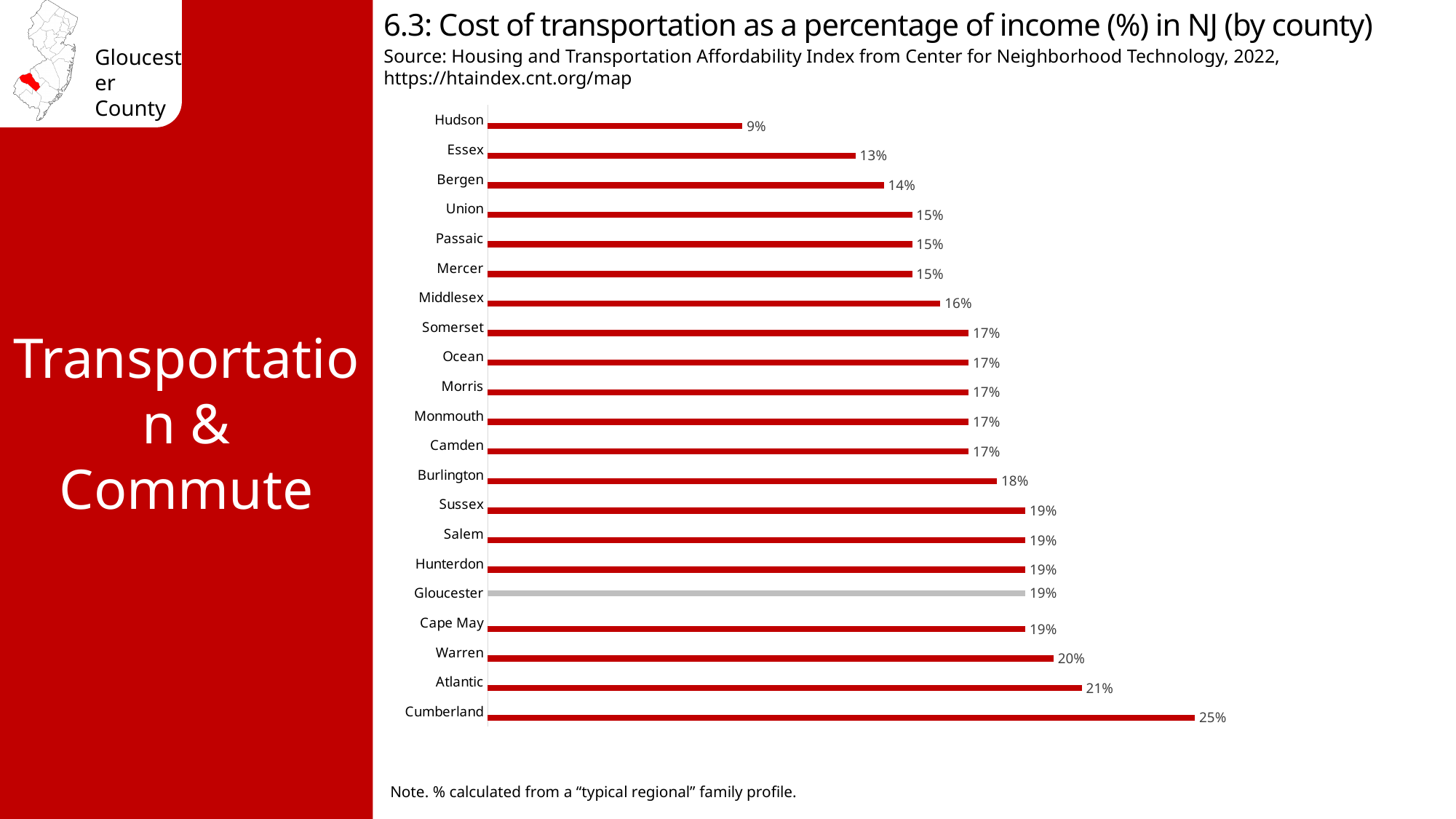
What is the difference between the values for Cumberland and Hudson? 16% Which has a higher value, Warren or Burlington? Warren What is the value shown for Middlesex County? 16% Which county has the highest cost of transportation as a percentage of income? Cumberland What is the cost of transportation as a percentage of income for Gloucester County? 19% Which has a higher value, Essex or Bergen? Bergen Which county's bar is shown in gray rather than red? Gloucester What is the difference between the values for Atlantic and Gloucester? 2% What type of chart is shown on the slide? Bar chart How many counties are shown in the chart? 21 What is the cost of transportation as a percentage of income for Hudson County? 9% Which county has the lowest cost of transportation as a percentage of income? Hudson